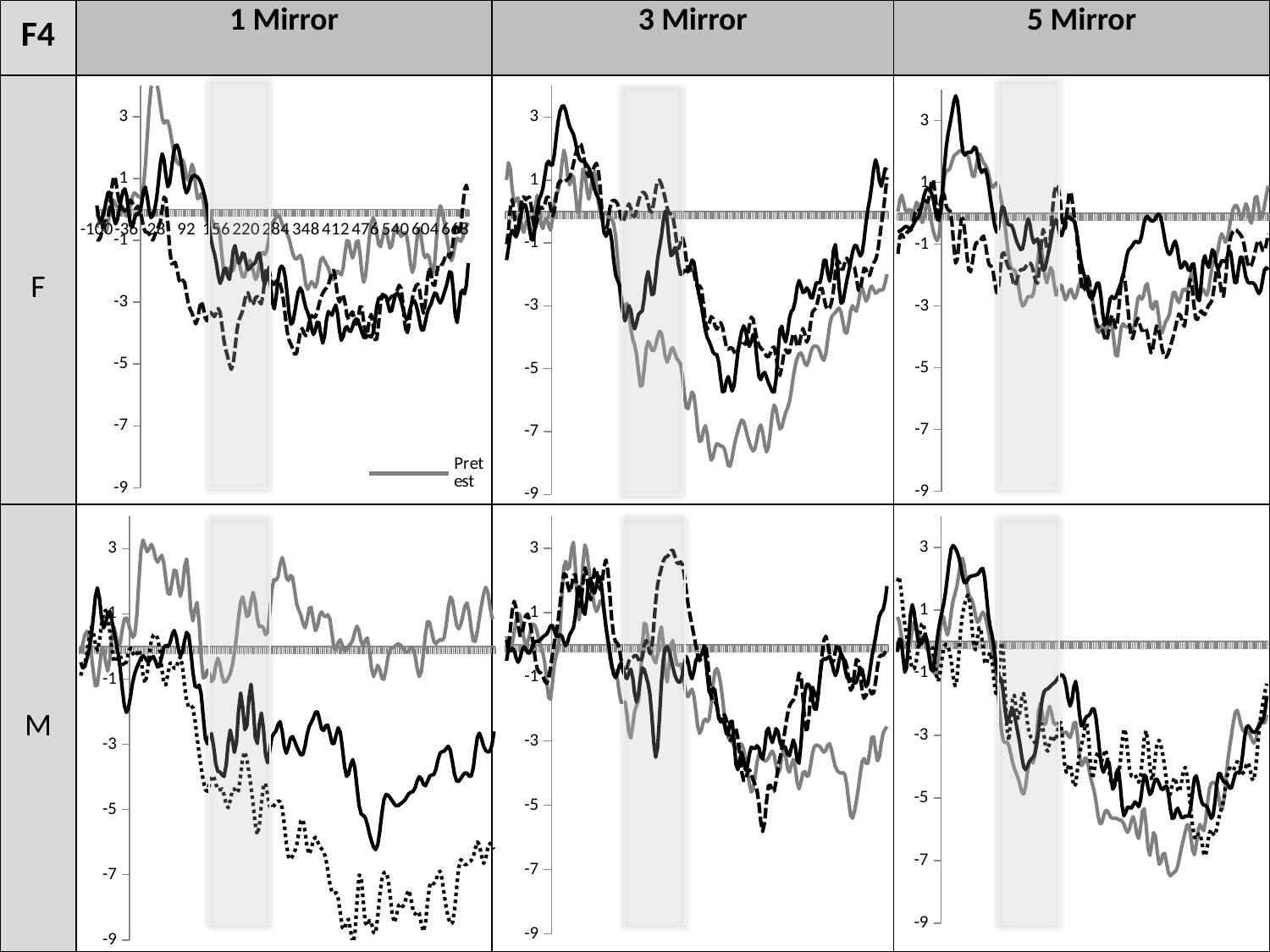
In the M / 1 Mirror chart, is the lowest value of the gray line greater or less than -3? greater How many charts are shown on the slide? 6 What is the lowest tick value shown on the y axis of the charts? -9 What series name is shown in the legend of the F / 1 Mirror chart? Pretest In the F row, which chart's gray line reaches the lowest value? 3 Mirror What is the highest tick value shown on the y axis of the charts? 3 In the F / 1 Mirror chart, what is the first x-axis tick label? -100 What are the three column headings above the charts? 1 Mirror, 3 Mirror, 5 Mirror In the M / 1 Mirror chart, is the lowest value of the dotted line greater or less than -7? less In the M / 1 Mirror chart, does the dotted line generally rise or fall from left to right? fall In the F / 3 Mirror chart, is the lowest value of the gray line greater or less than -7? less What kind of chart is used in each panel of the slide? line chart